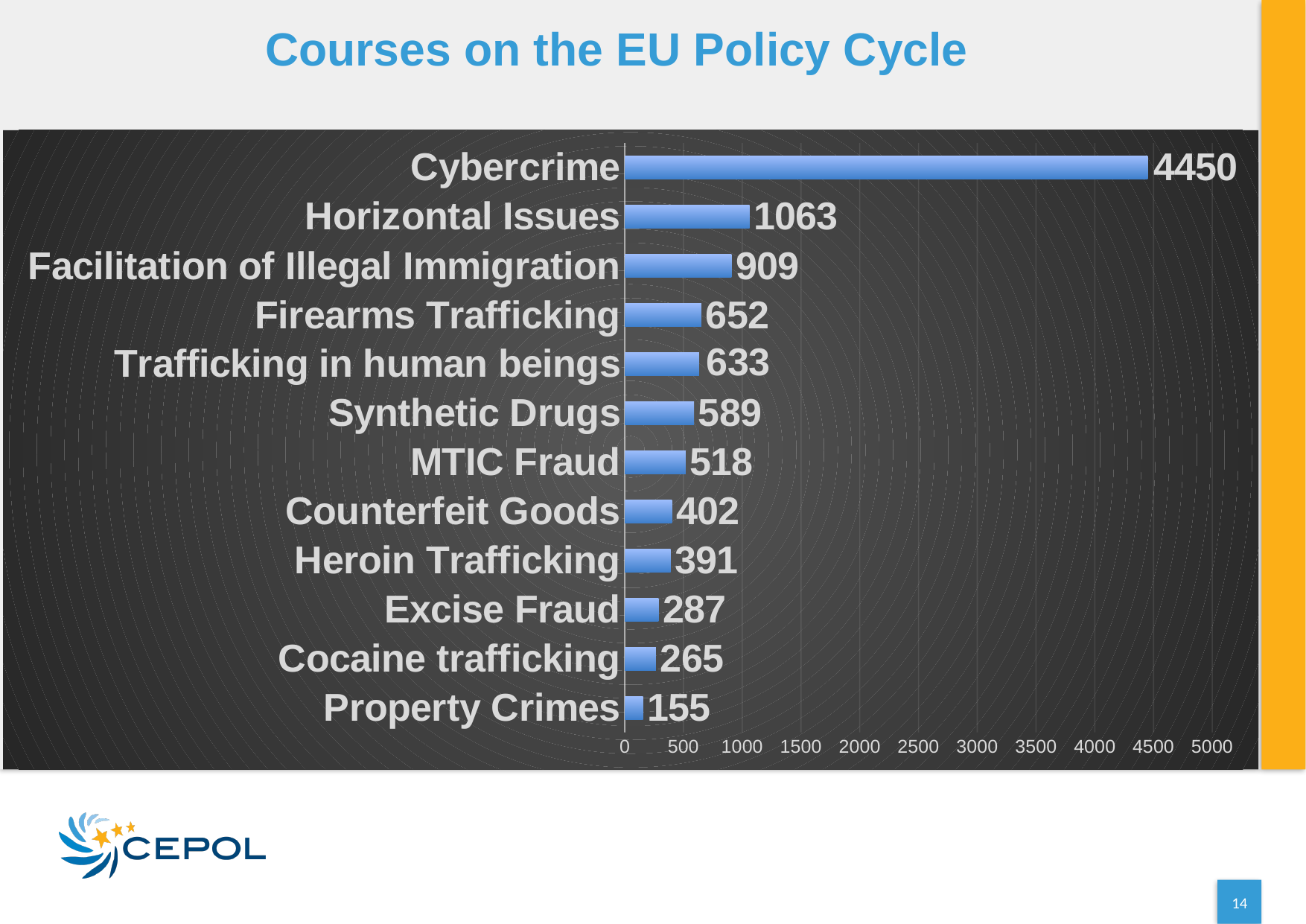
What is the difference between the values for Cybercrime and Horizontal Issues? 3387 How many categories are shown in the chart? 12 What is the title of the slide? Courses on the EU Policy Cycle What kind of chart is shown on the slide? Bar chart Which category has the lowest value? Property Crimes What is the difference between the values for Firearms Trafficking and Trafficking in human beings? 19 What is the value for Cybercrime? 4450 Which category has the highest value? Cybercrime What is the value for Synthetic Drugs? 589 Which is larger, the value for Counterfeit Goods or the value for Heroin Trafficking? Counterfeit Goods What is the value for Property Crimes? 155 What is the value for Facilitation of Illegal Immigration? 909